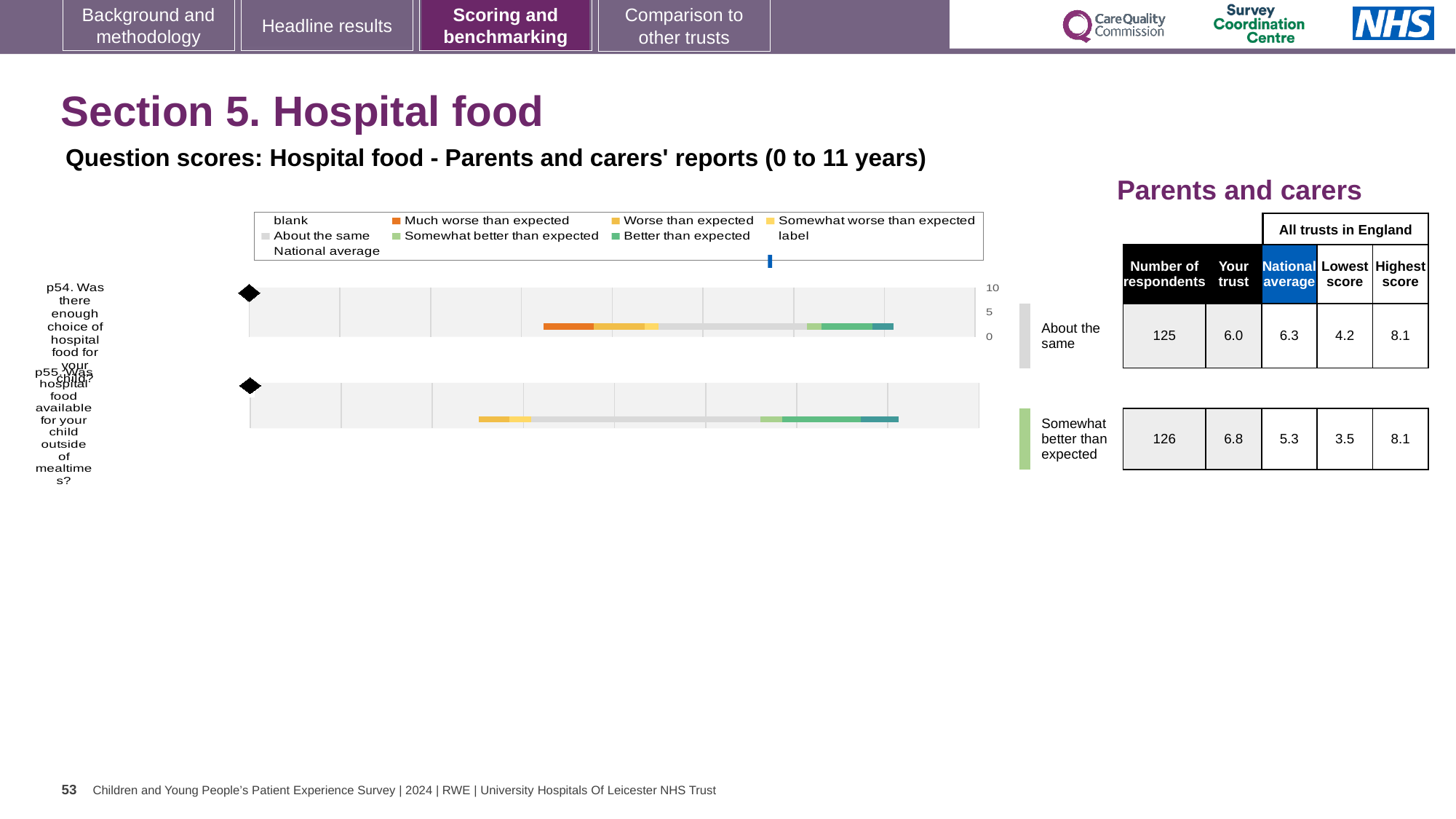
What kind of chart is used to show the question scores for hospital food? bar chart How many questions (categories) are plotted in the hospital food chart? 2 In the chart legend, what colour represents 'About the same'? grey How many entries does the legend of the hospital food chart list? 9 According to the table beside the chart, what is the highest score among all trusts in England for p55? 8.1 For p55, what is the difference between the 'Your trust' score (6.8) and the national average (5.3)? 1.5 In the chart legend, what colour represents 'Much worse than expected'? orange Which benchmark category is shown for p55 (hospital food available outside of mealtimes)? Somewhat better than expected According to the table beside the chart, how many respondents answered p54 (enough choice of hospital food)? 125 According to the table beside the chart, what is the national average score for p54? 6.3 For p55, which is larger: the 'Your trust' score or the national average? Your trust According to the table beside the chart, what is the 'Your trust' score for p55 (hospital food available outside of mealtimes)? 6.8